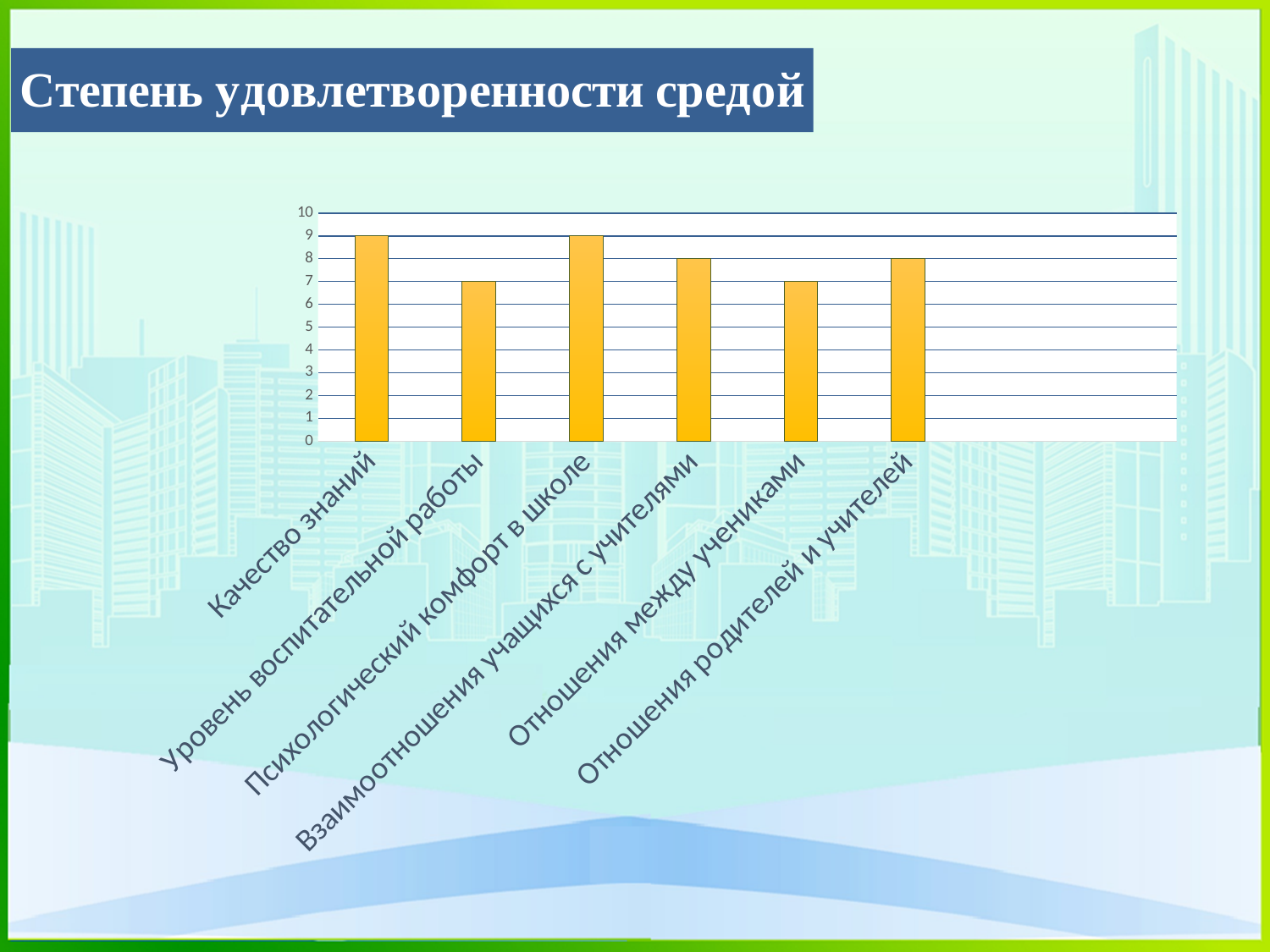
Which is larger: the value for "Качество знаний" or the value for "Уровень воспитательной работы"? Качество знаний What type of chart is shown on the slide? bar chart Is the value for "Отношения родителей и учителей" greater or less than 5? greater What is the value for "Отношения между учениками"? 7 What is the value for "Психологический комфорт в школе"? 9 How many categories are plotted in the chart? 6 What is the title shown above the chart on the slide? Степень удовлетворенности средой What is the value for "Отношения родителей и учителей"? 8 What is the difference between the values for "Психологический комфорт в школе" and "Отношения между учениками"? 2 What is the value for "Качество знаний"? 9 What is the value for "Взаимоотношения учащихся с учителями"? 8 What is the value for "Уровень воспитательной работы"? 7